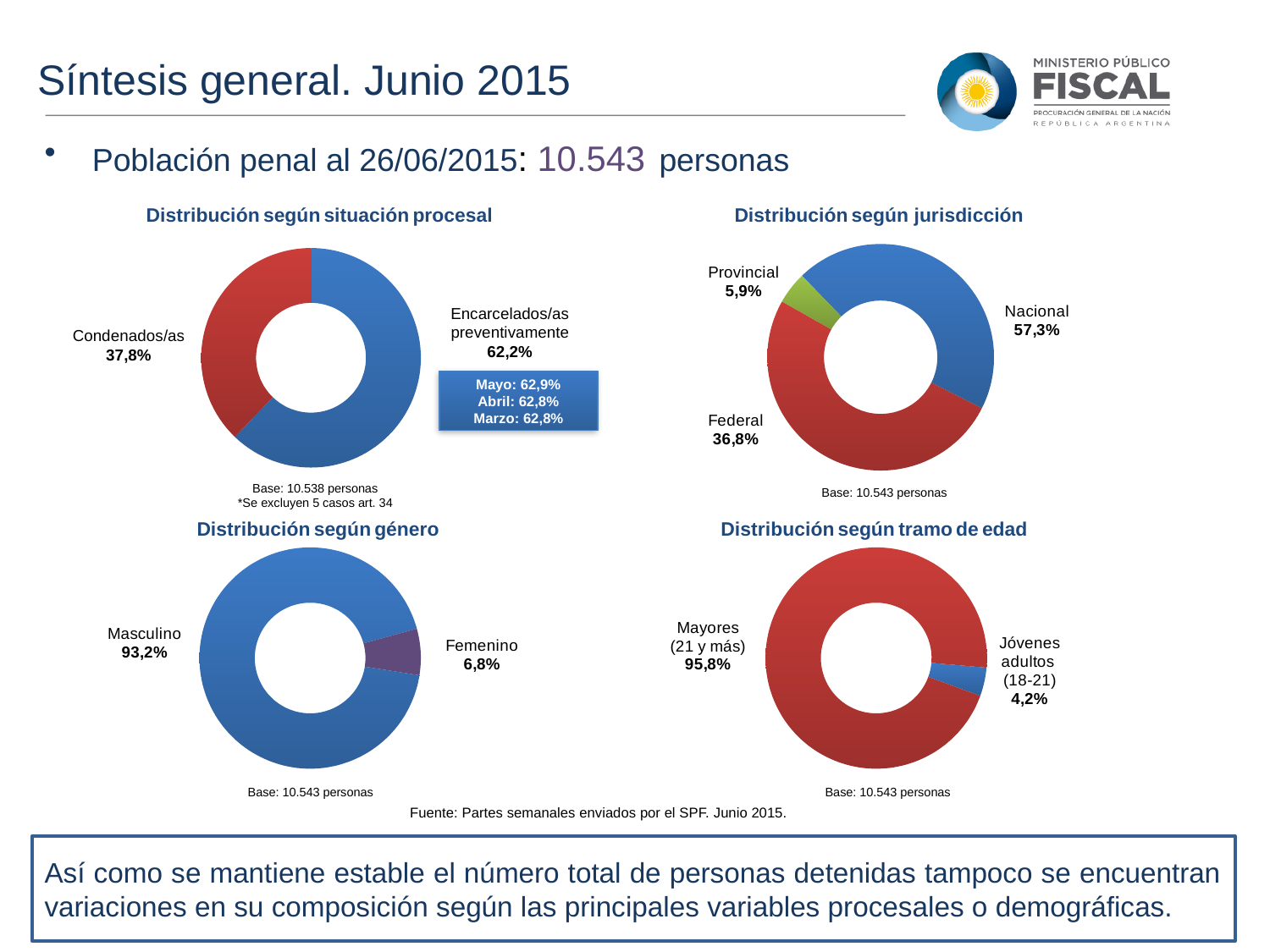
In the 'Distribución según tramo de edad' chart, what share is labelled for Jóvenes adultos (18-21)? 4,2% In the 'Distribución según situación procesal' chart, what share is labelled for Encarcelados/as preventivamente? 62,2% In the 'Distribución según género' chart, what share is labelled for Femenino? 6,8% In the 'Distribución según jurisdicción' chart, which category has the smallest share? Provincial In the 'Distribución según jurisdicción' chart, how many categories are shown? 3 In the 'Distribución según situación procesal' chart, what value is shown for Mayo in the blue box? 62,9% In the 'Distribución según género' chart, which is larger, Masculino or Femenino? Masculino In the 'Distribución según jurisdicción' chart, what is the difference between the Nacional and Federal shares? 20,5% In the 'Distribución según situación procesal' chart, what share is labelled for Condenados/as? 37,8% What kind of chart is used for 'Distribución según tramo de edad'? Donut (pie) chart In the 'Distribución según jurisdicción' chart, what share is labelled for Federal? 36,8%